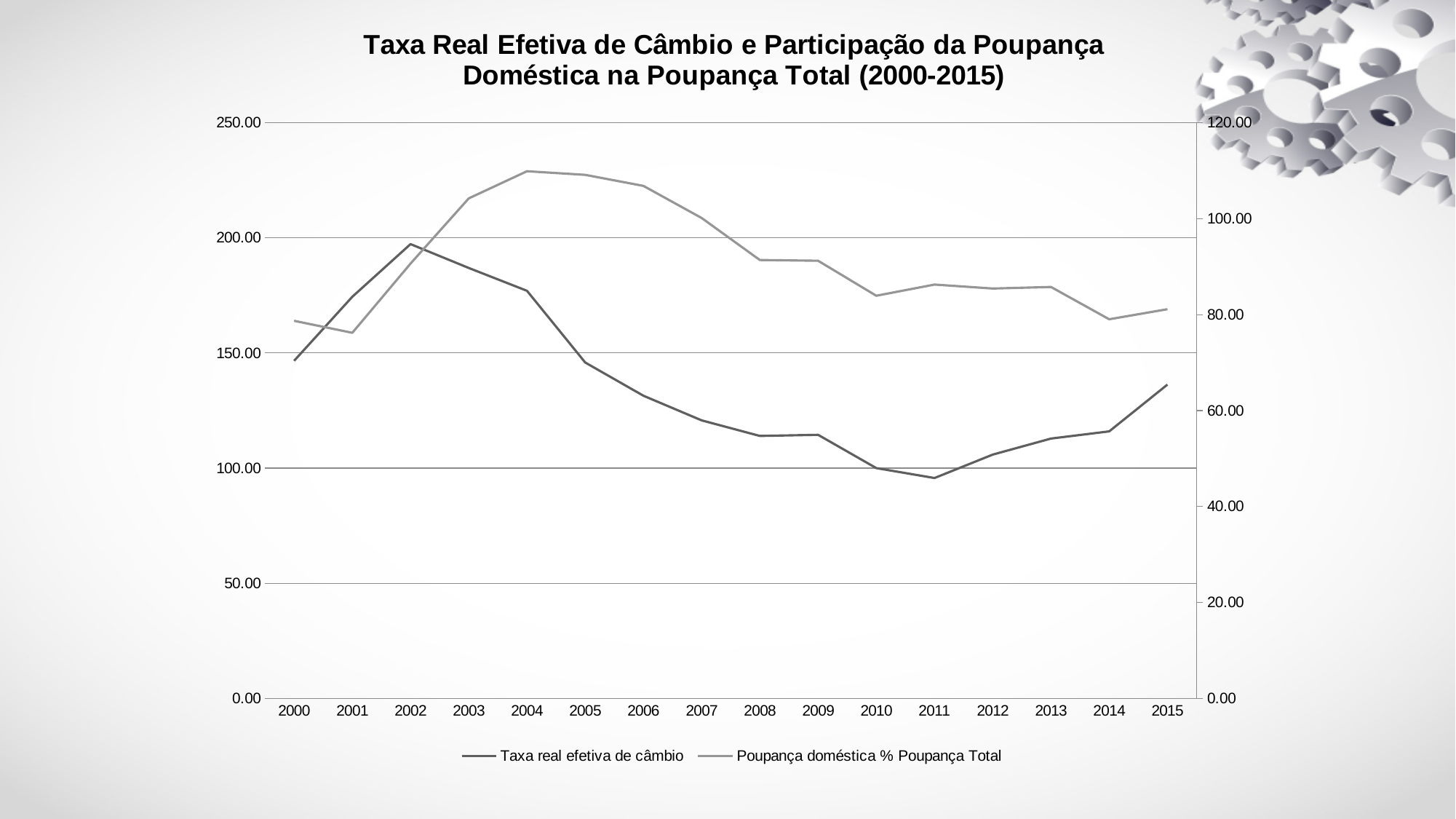
Does the 'Taxa real efetiva de câmbio' line rise or fall between 2002 and 2011? Fall How many series does the legend list? 2 What is the title of the chart? Taxa Real Efetiva de Câmbio e Participação da Poupança Doméstica na Poupança Total (2000-2015) How many years are plotted along the x axis? 16 In which year does the 'Poupança doméstica % Poupança Total' line reach its lowest point? 2001 In which year does the 'Poupança doméstica % Poupança Total' line reach its highest point? 2004 In which year does the 'Taxa real efetiva de câmbio' line reach its lowest point? 2011 What kind of chart is shown on the slide? Line chart For the 'Taxa real efetiva de câmbio' line, which year is higher: 2004 or 2005? 2004 Does the 'Poupança doméstica % Poupança Total' line rise or fall between 2004 and 2010? Fall Does the 'Taxa real efetiva de câmbio' line rise or fall between 2011 and 2015? Rise In which year does the 'Taxa real efetiva de câmbio' line reach its highest point? 2002